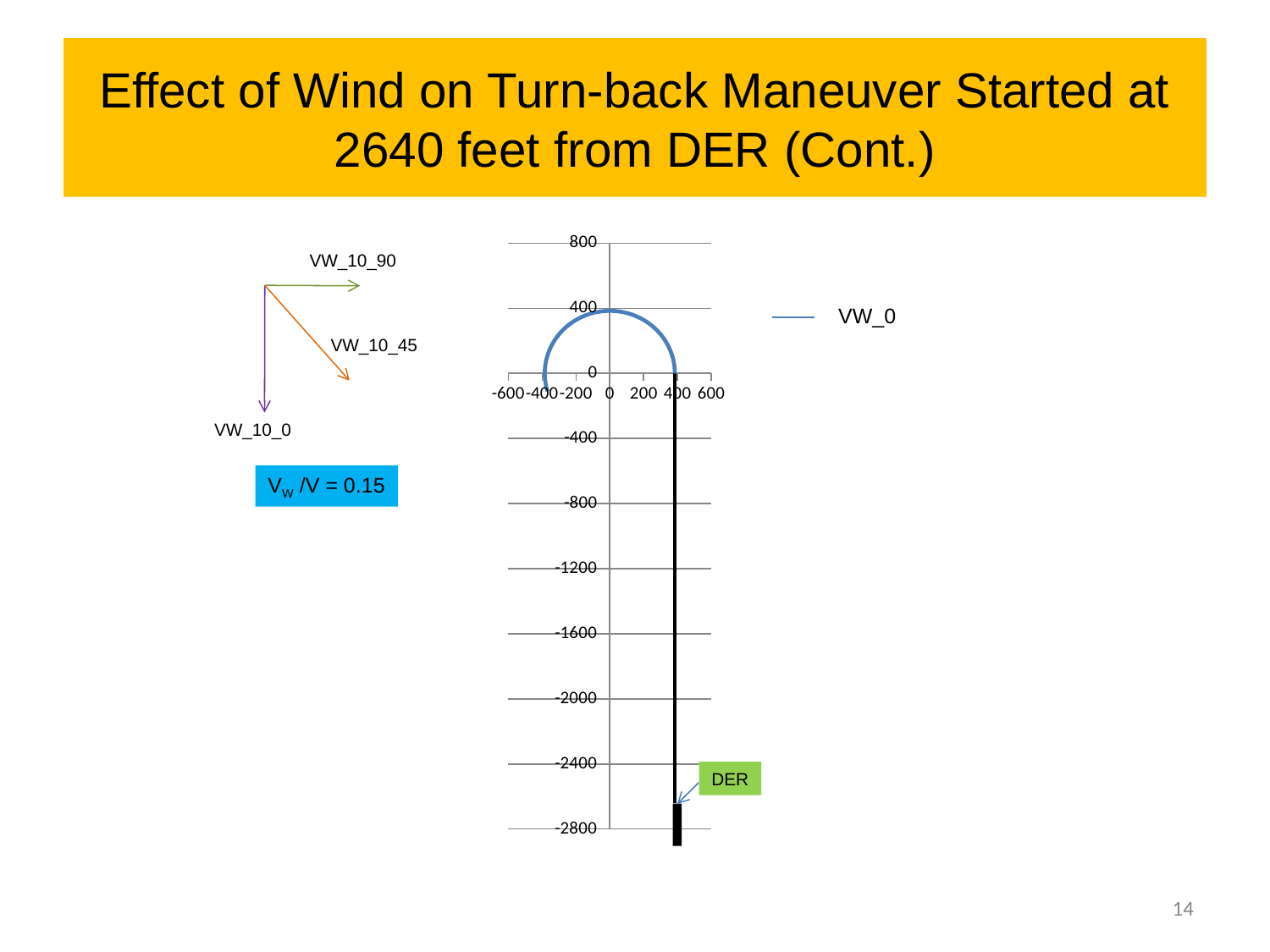
What is the highest value labelled on the chart's vertical axis? 800 What label is attached by an arrow to the bottom of the vertical black line in the chart? DER What is the largest value labelled on the chart's horizontal axis? 600 What is the lowest value labelled on the chart's vertical axis? -2800 How many series does the chart legend list? 1 What kind of chart is shown on the slide? line chart What is the name of the series listed in the chart legend? VW_0 How many tick labels are shown on the chart's horizontal axis? 7 How many tick labels are shown on the chart's vertical axis? 10 Is the highest point of the VW_0 curve greater or less than 800 on the vertical axis? less Is the highest point of the VW_0 curve greater or less than 0 on the vertical axis? greater Is the leftmost point of the VW_0 curve greater or less than -200 on the horizontal axis? less